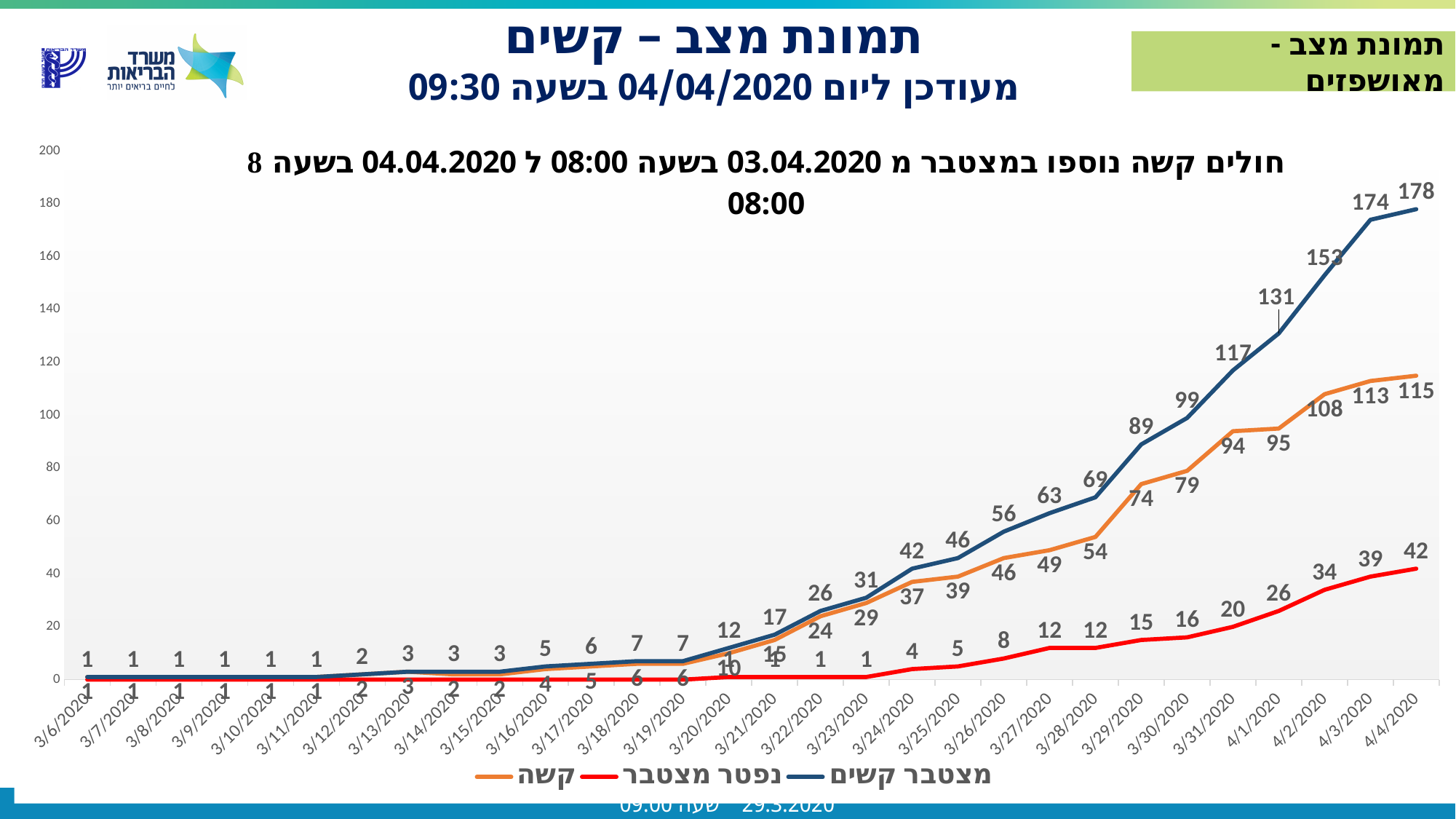
How many series does the legend list? 3 How many dates are shown on the x axis? 30 What is the value of the מצטבר קשים series on 3/29/2020? 89 What is the value of the נפטר מצטבר series on 4/3/2020? 39 What is the value of the קשה series on 4/2/2020? 108 On which date does the מצטבר קשים series reach its highest value? 4/4/2020 What is the difference between the נפטר מצטבר values on 4/4/2020 and 4/1/2020? 16 What is the value of the מצטבר קשים series on 4/4/2020? 178 What is the difference between the מצטבר קשים value and the קשה value on 4/4/2020? 63 What type of chart is shown on the slide? line chart Does the מצטבר קשים series rise or fall from 3/6/2020 to 4/4/2020? rise Which series has the larger value on 3/31/2020, מצטבר קשים or קשה? מצטבר קשים